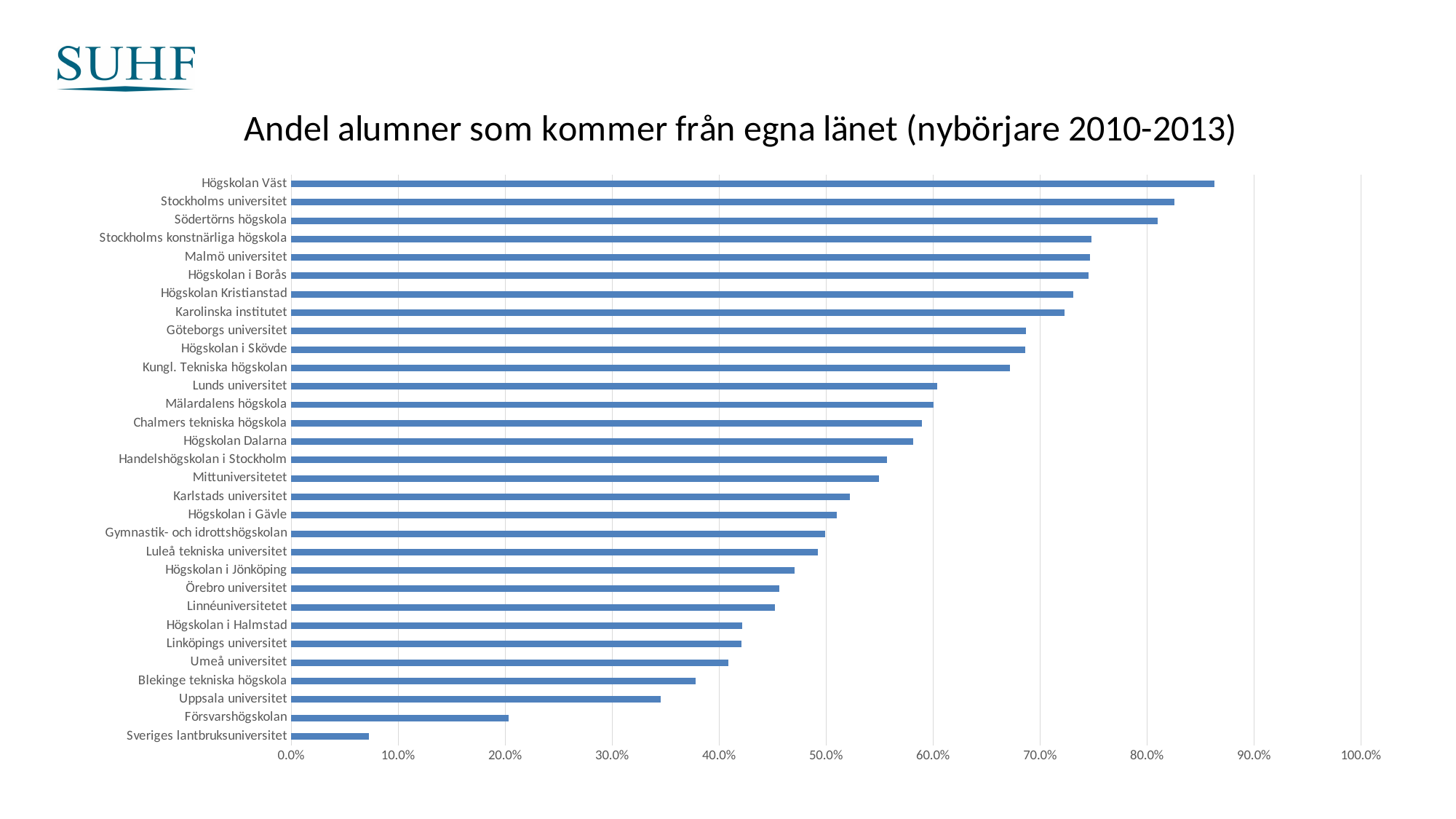
Is the value for Karolinska institutet greater or less than 70.0%? greater Is the value for Uppsala universitet greater or less than 40.0%? less Which institution has the lowest share of alumni from its own county? Sveriges lantbruksuniversitet Which has a larger value, Högskolan Väst or Stockholms universitet? Högskolan Väst How many institutions are listed in the chart? 31 Is the value for Sveriges lantbruksuniversitet greater or less than 10.0%? less Which institution has the highest share of alumni from its own county? Högskolan Väst Which has a larger value, Blekinge tekniska högskola or Uppsala universitet? Blekinge tekniska högskola What is the title of the chart? Andel alumner som kommer från egna länet (nybörjare 2010-2013) What kind of chart is shown on the slide? bar chart